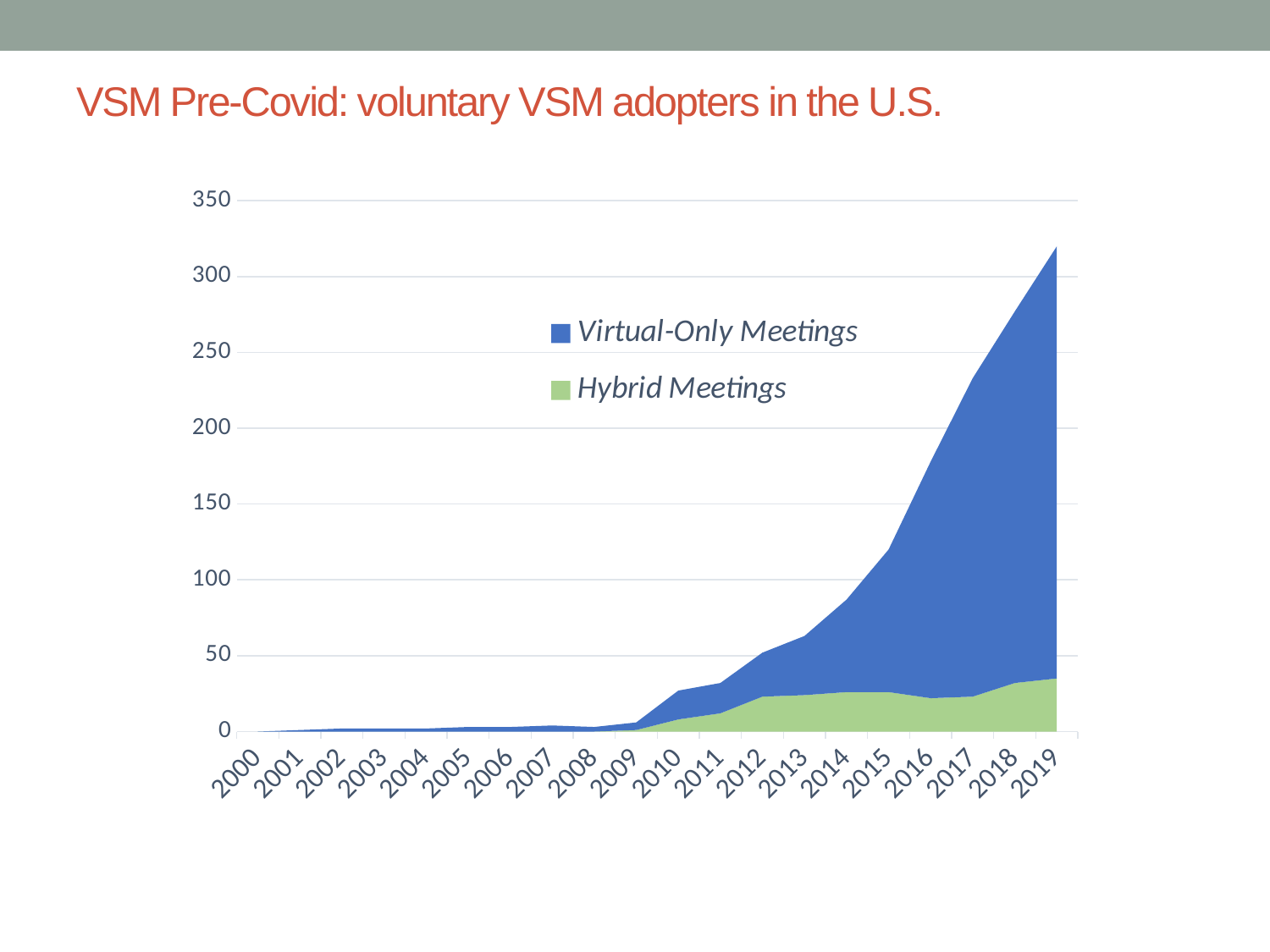
Which year has the lowest total number of VSM adopters? 2000 How many series does the legend list? 2 Is the total value for 2019 greater or less than 300? greater Which series is larger in 2019, Virtual-Only Meetings or Hybrid Meetings? Virtual-Only Meetings How many years are shown along the x axis? 20 Is the total value for 2015 greater or less than 100? greater What are the two series named in the legend? Virtual-Only Meetings and Hybrid Meetings What kind of chart is shown on the slide? Area chart Do the total values generally rise or fall from 2000 to 2019? Rise Which year has the highest total number of VSM adopters? 2019 Is the total value for 2010 greater or less than 50? less